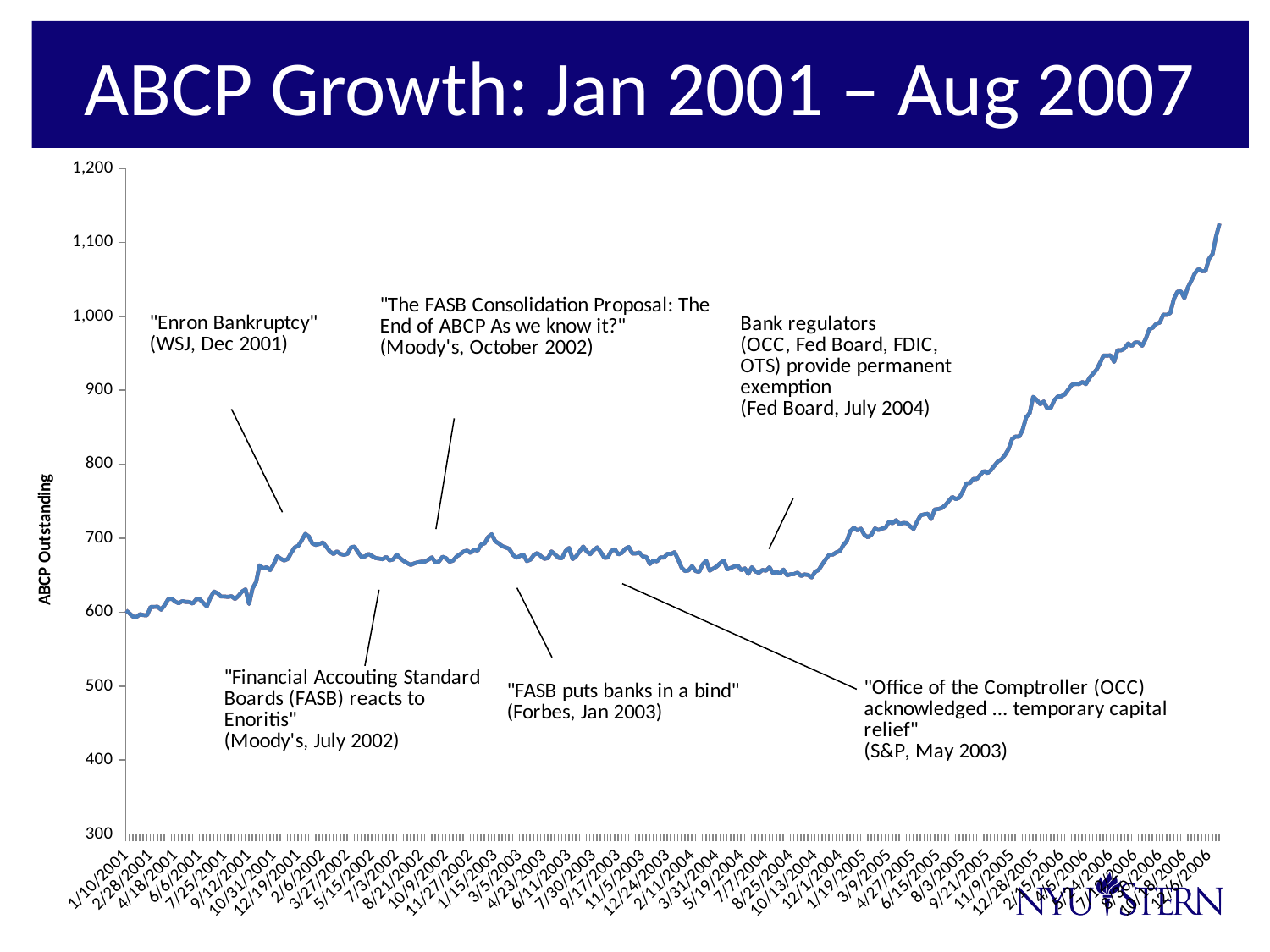
What is the label on the vertical axis of the chart? ABCP Outstanding Is the value of ABCP Outstanding at the end of the series (2007) greater or less than 1,000? greater What is the title of the chart on the slide? ABCP Growth: Jan 2001 – Aug 2007 Overall, does ABCP Outstanding rise or fall from the start of the series in January 2001 to the end in 2007? rise Does ABCP Outstanding rise or fall between 10/13/2004 and the end of the series? rise Is the value of ABCP Outstanding around 12/28/2005 greater or less than 800? greater What is the highest value shown on the vertical axis of the chart? 1,200 Which is larger, ABCP Outstanding at the start of the series (January 2001) or at the end of the series (2007)? end of the series (2007) Is the value of ABCP Outstanding around 2/6/2002 greater or less than 800? less What kind of chart is shown on the slide? line chart